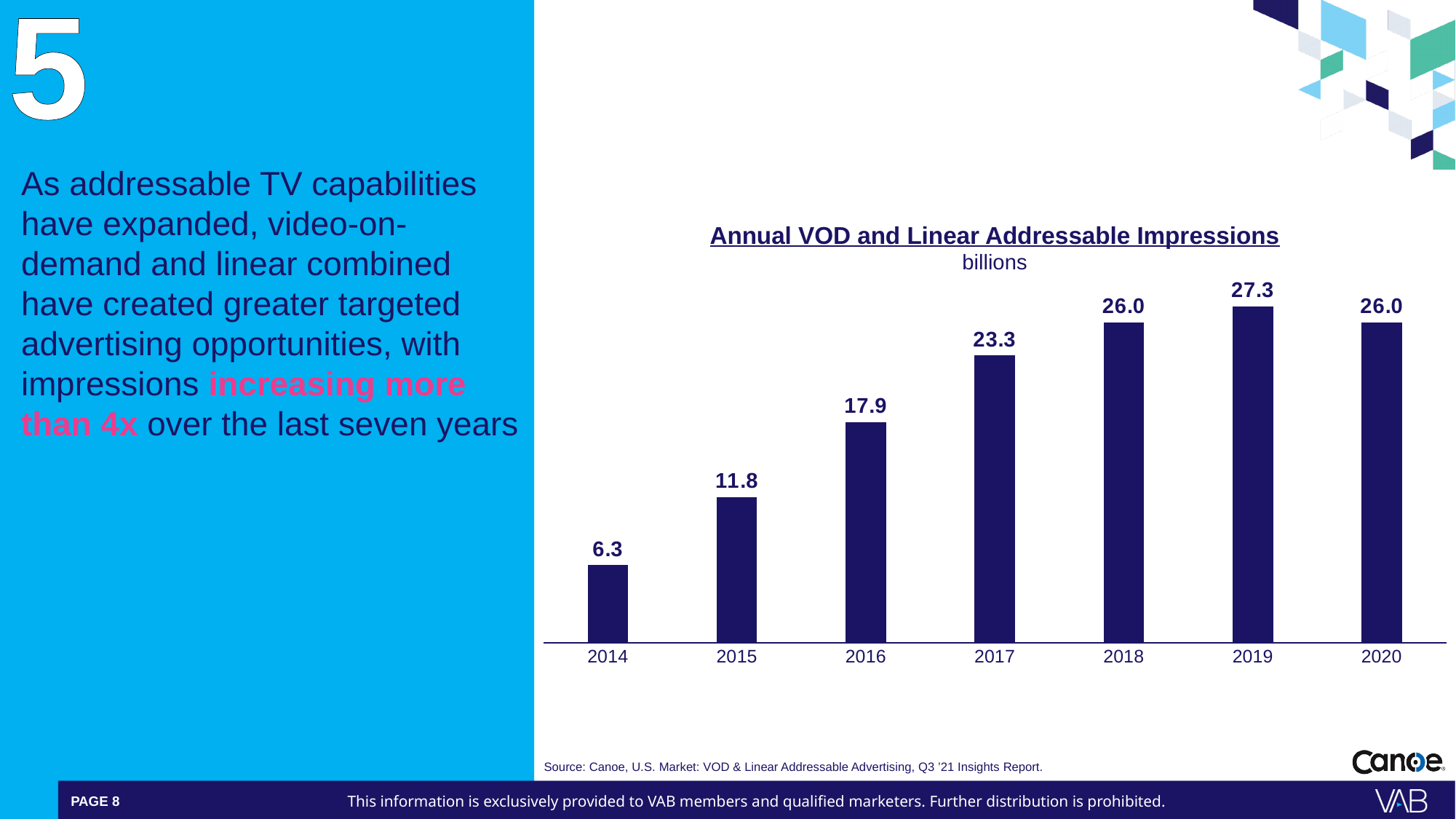
What is the value for 2020 in the Annual VOD and Linear Addressable Impressions chart? 26.0 What is the value for 2014 in the Annual VOD and Linear Addressable Impressions chart? 6.3 What unit is stated under the title of the Annual VOD and Linear Addressable Impressions chart? billions How many years are shown in the Annual VOD and Linear Addressable Impressions chart? 7 Which is larger in the Annual VOD and Linear Addressable Impressions chart, the value for 2016 or the value for 2017? 2017 What is the difference between the 2019 and 2014 values in the Annual VOD and Linear Addressable Impressions chart? 21.0 What kind of chart is the Annual VOD and Linear Addressable Impressions chart? Bar chart Which year has the highest value in the Annual VOD and Linear Addressable Impressions chart? 2019 Which year has the lowest value in the Annual VOD and Linear Addressable Impressions chart? 2014 Do the values in the Annual VOD and Linear Addressable Impressions chart rise or fall from 2014 to 2019? Rise What is the value for 2017 in the Annual VOD and Linear Addressable Impressions chart? 23.3 What is the difference between the 2016 and 2015 values in the Annual VOD and Linear Addressable Impressions chart? 6.1